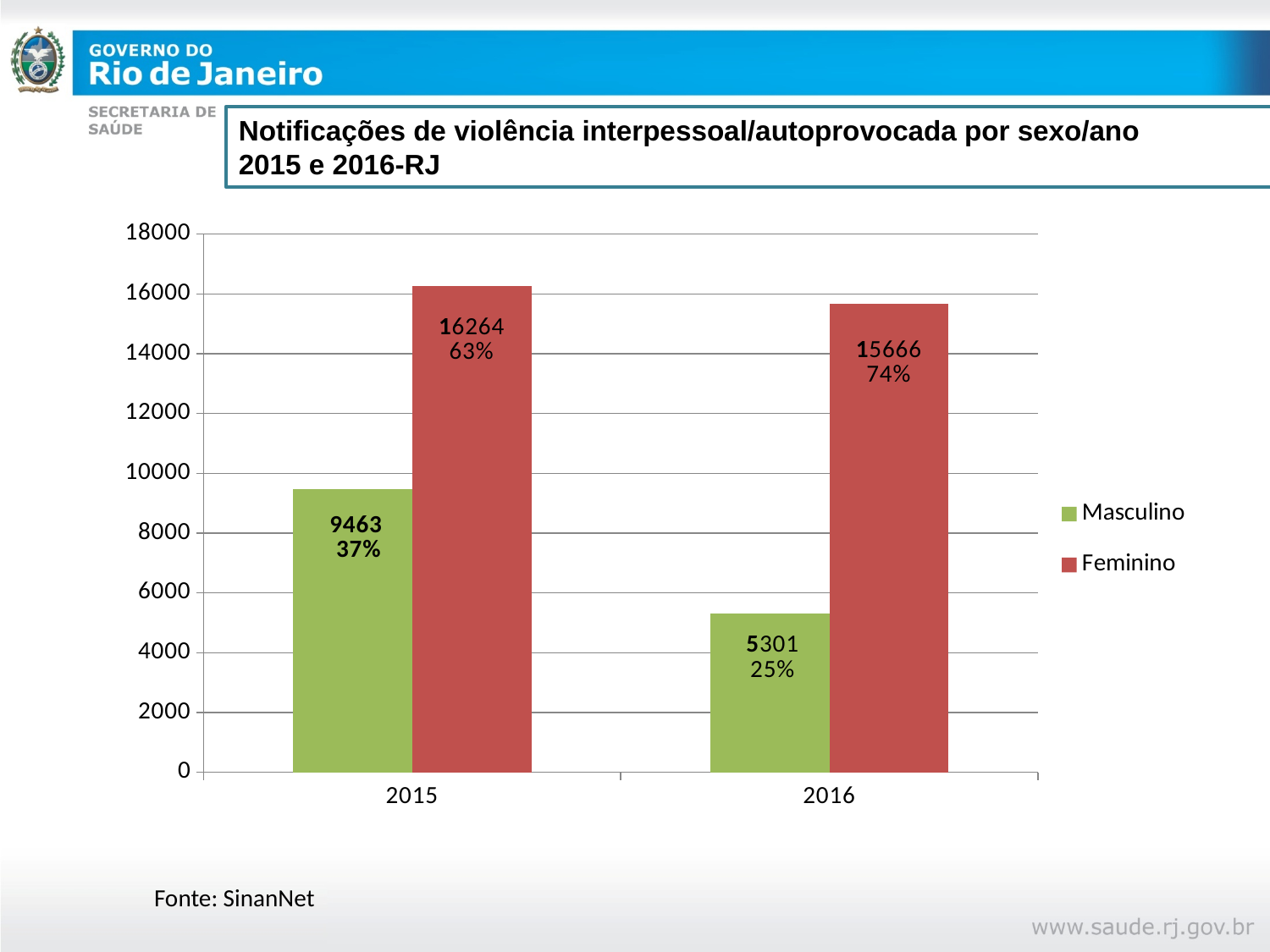
Which bar has the lowest value on the chart? Masculino in 2016 Which series has the highest value in 2016? Feminino What percentage is shown on the Masculino bar for 2016? 25% What percentage is shown on the Feminino bar for 2015? 63% What is the difference between the Feminino and Masculino values in 2015? 6801 What is the value for Masculino in 2015? 9463 How many series does the legend list? 2 What is the source cited below the chart? SinanNet How many years are shown on the x axis? 2 Which is larger, the Masculino value in 2015 or the Masculino value in 2016? Masculino in 2015 What kind of chart is this? Bar chart What is the value for Feminino in 2016? 15666